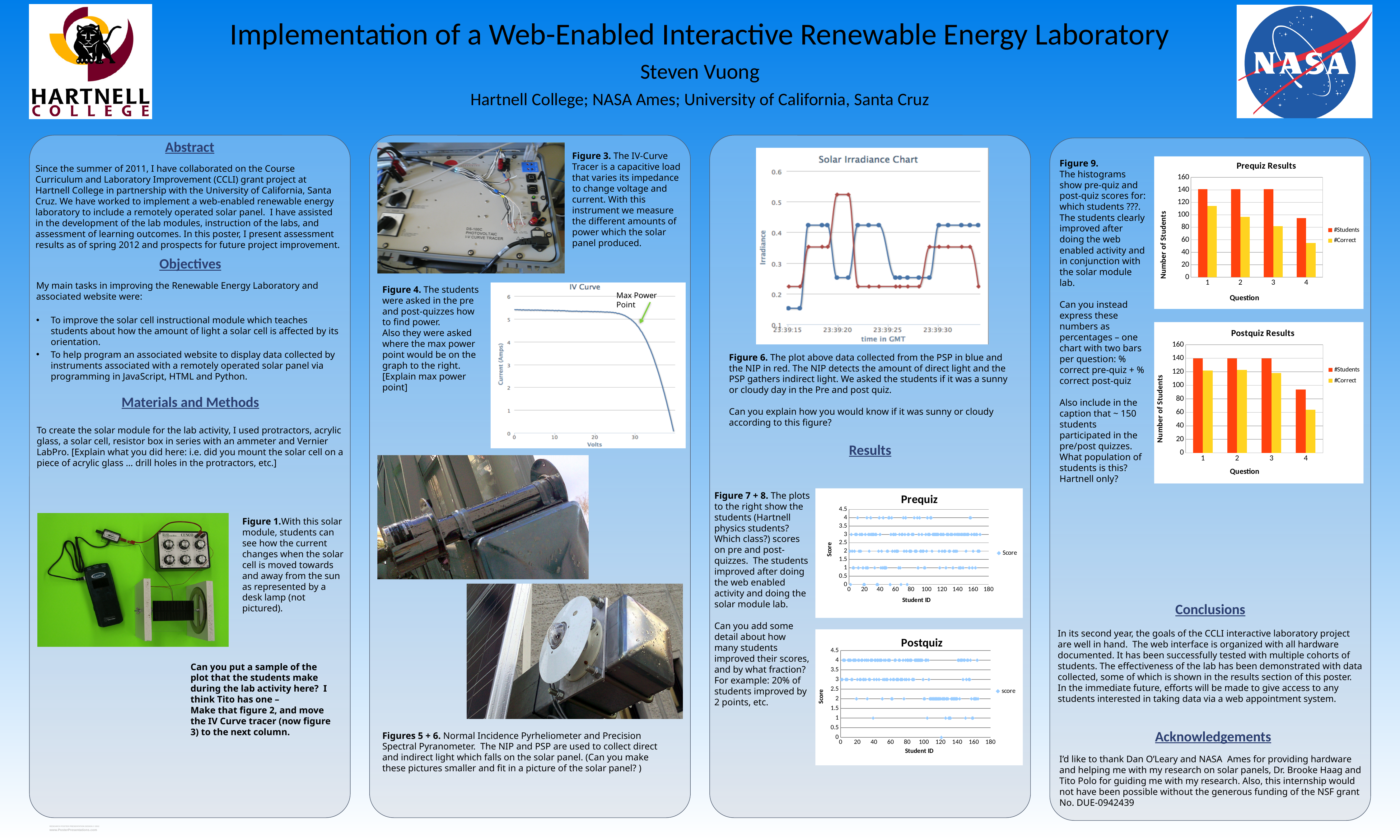
How many questions are shown on the x axis of the "Prequiz Results" chart? 4 In the "Prequiz Results" chart, is the #Students value for question 4 greater or less than 80? greater How many series does the legend of the "Postquiz Results" chart list? 2 In the "Postquiz Results" chart, is the #Correct value for question 1 greater or less than 100? greater In the "Prequiz Results" chart, which question has the lowest #Correct value? 4 What is the y-axis label of the "Postquiz Results" chart? Number of Students What is the x-axis label of the "Prequiz" scatter chart? Student ID What kind of chart is the "Prequiz Results" chart? bar chart In the "IV Curve" chart, does the current rise or fall as the voltage increases along the x axis? fall In the "Postquiz Results" chart, which question has the lowest #Correct value? 4 In the "Prequiz Results" chart, which is larger for question 3: #Students or #Correct? #Students